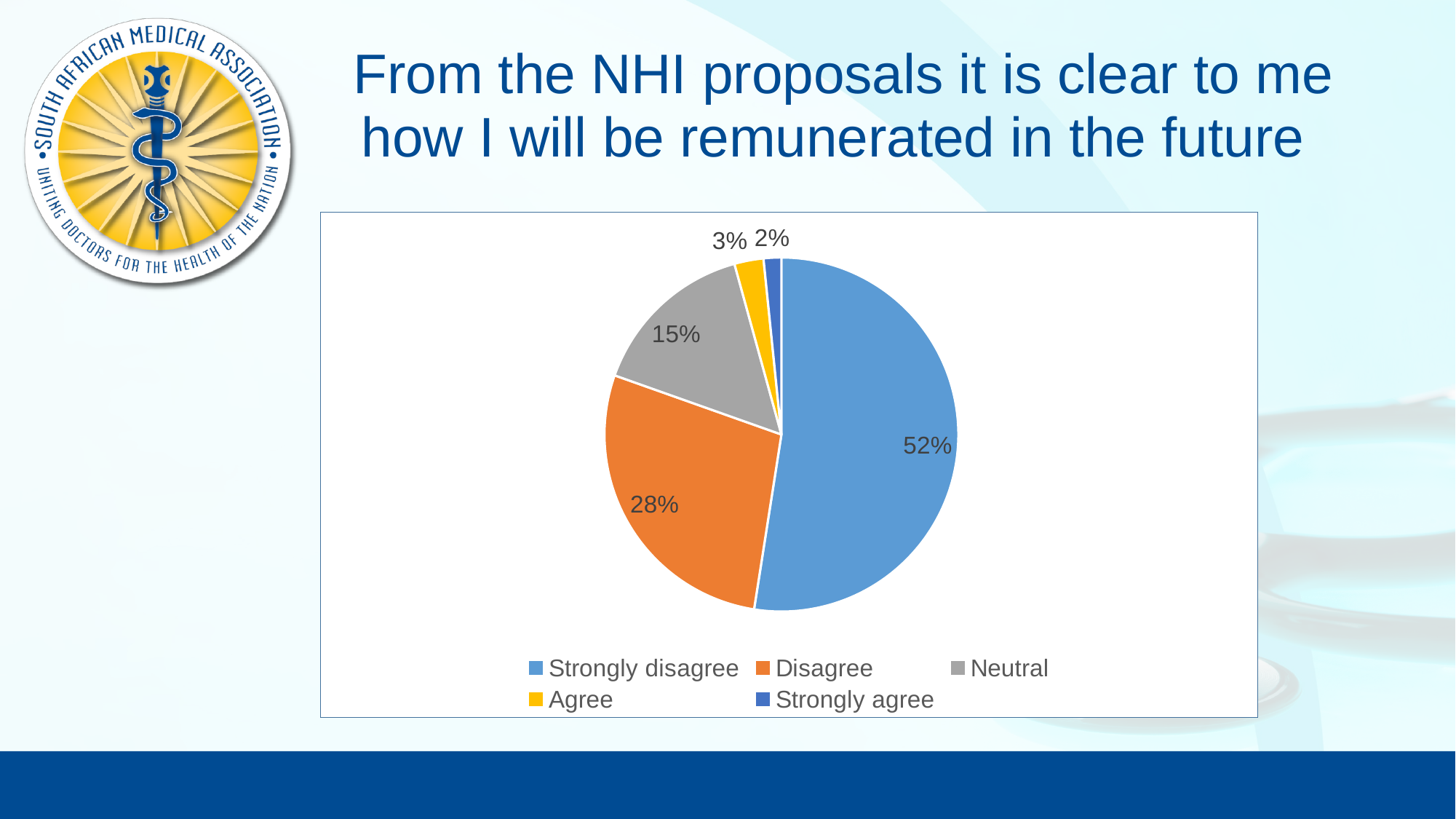
What share of respondents answered 'Disagree'? 28% Which is larger, the share for 'Neutral' or the share for 'Agree'? Neutral What share of respondents answered 'Agree'? 3% How many response categories does the legend list? 5 What share of respondents answered 'Strongly agree'? 2% Which response category has the smallest slice of the pie? Strongly agree What is the difference in percentage points between 'Strongly disagree' and 'Disagree'? 24 What share of respondents answered 'Strongly disagree'? 52% Which response category has the largest slice of the pie? Strongly disagree What kind of chart is shown on the slide? pie chart Which colour represents 'Disagree' in the pie chart? orange What share of respondents answered 'Neutral'? 15%